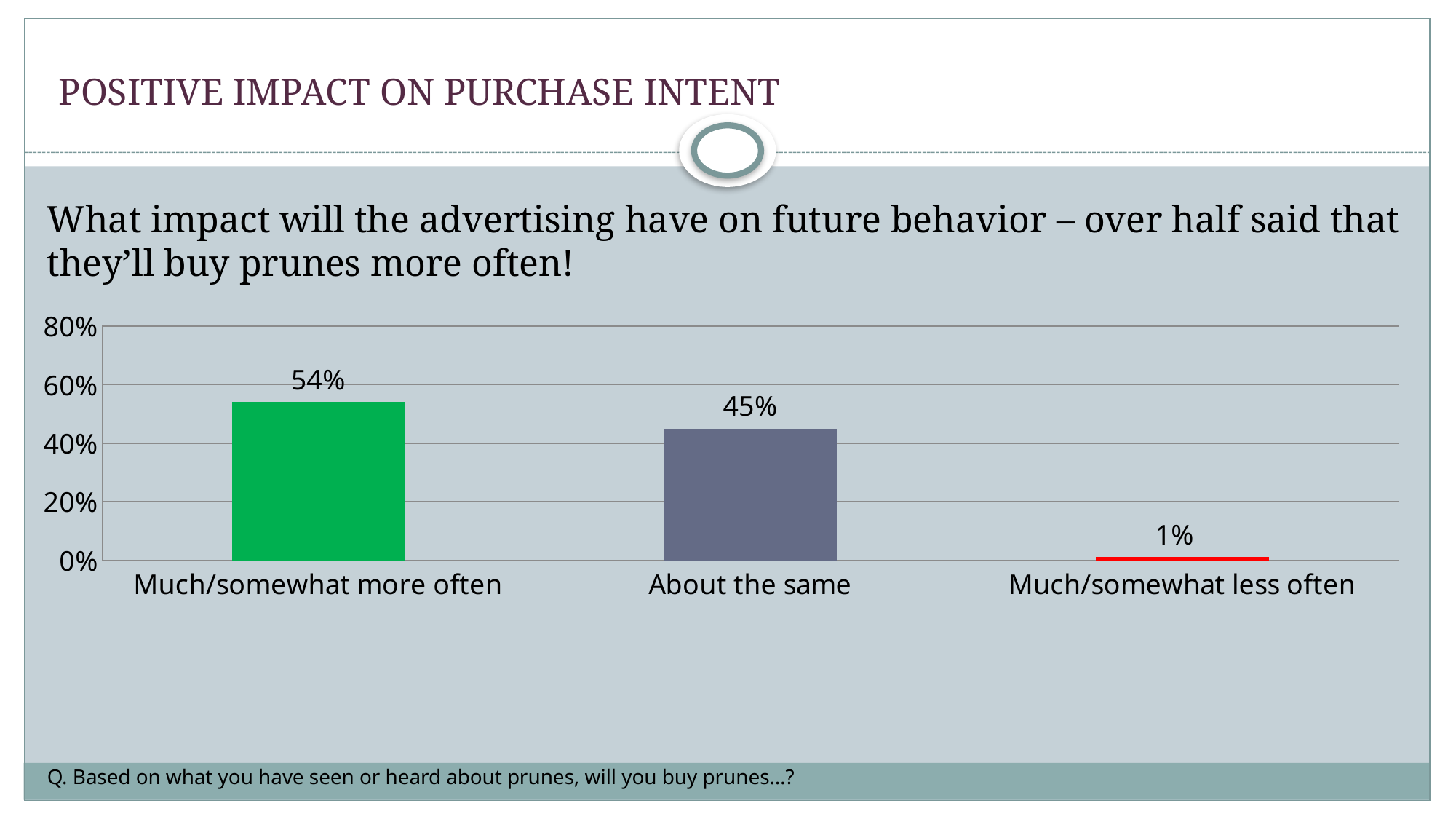
Which category has the highest value? Much/somewhat more often How many categories are shown on the chart? 3 What is the difference between the values for "Much/somewhat more often" and "About the same"? 9% Is the value for "About the same" greater or less than 40%? greater What is the value for "Much/somewhat more often"? 54% What kind of chart is shown on the slide? Bar chart Which category has the lowest value? Much/somewhat less often What is the value for "About the same"? 45% What is the difference between the values for "About the same" and "Much/somewhat less often"? 44% What colour is the bar for "Much/somewhat more often"? Green Which is larger, the value for "Much/somewhat more often" or the value for "About the same"? Much/somewhat more often What is the value for "Much/somewhat less often"? 1%